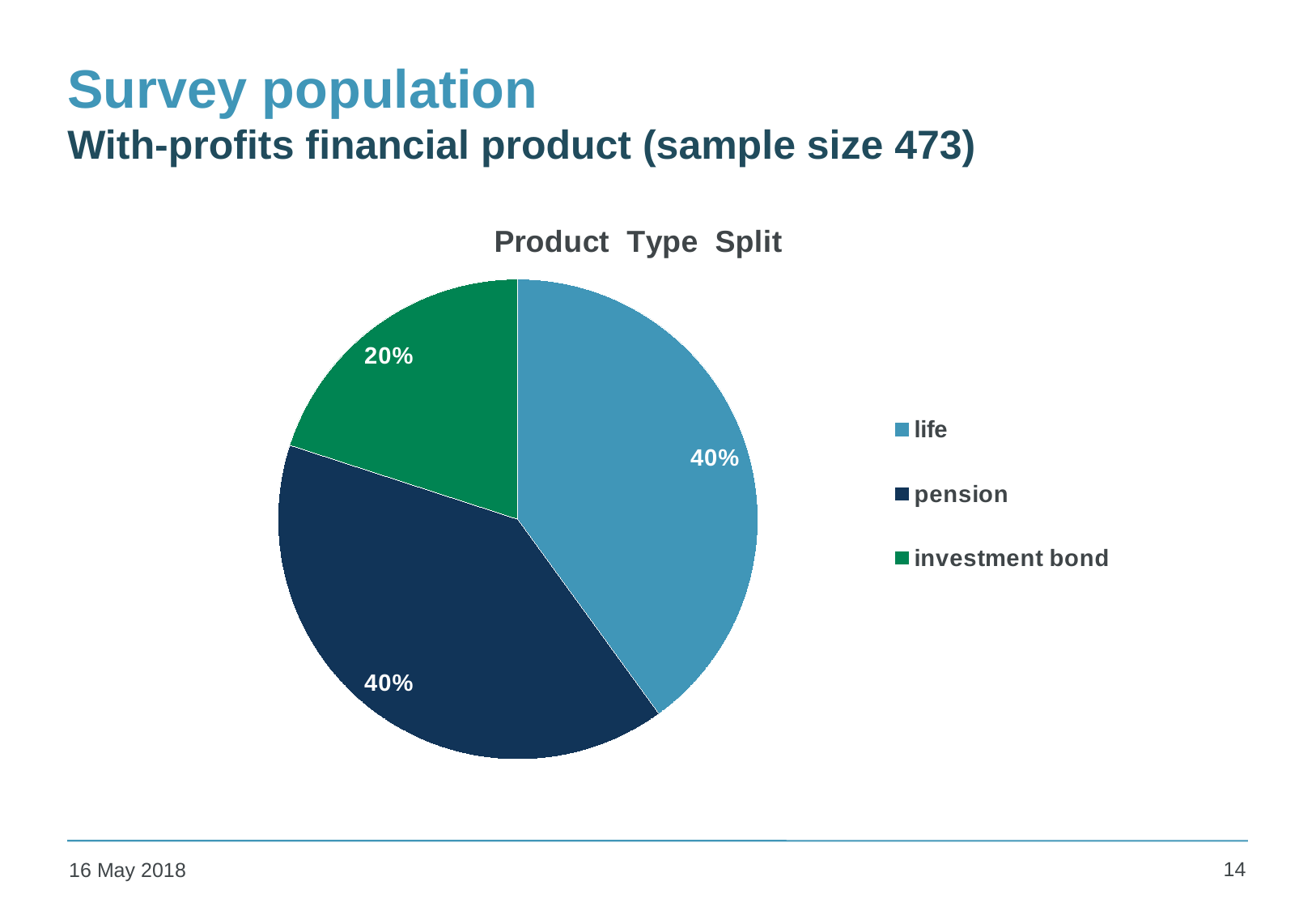
What share of the pie does the life slice represent? 40% What share of the pie does the pension slice represent? 40% What is the title of the chart? Product Type Split Which category has the smallest slice of the pie? investment bond Which is larger, the pension slice or the investment bond slice? pension What colour is the investment bond slice? green How many categories does the pie chart show? 3 What is the combined share of the life and pension slices? 80% What share of the pie does the investment bond slice represent? 20% How many entries does the legend list? 3 What is the difference in percentage points between the life slice and the investment bond slice? 20% What kind of chart is shown on the slide? pie chart